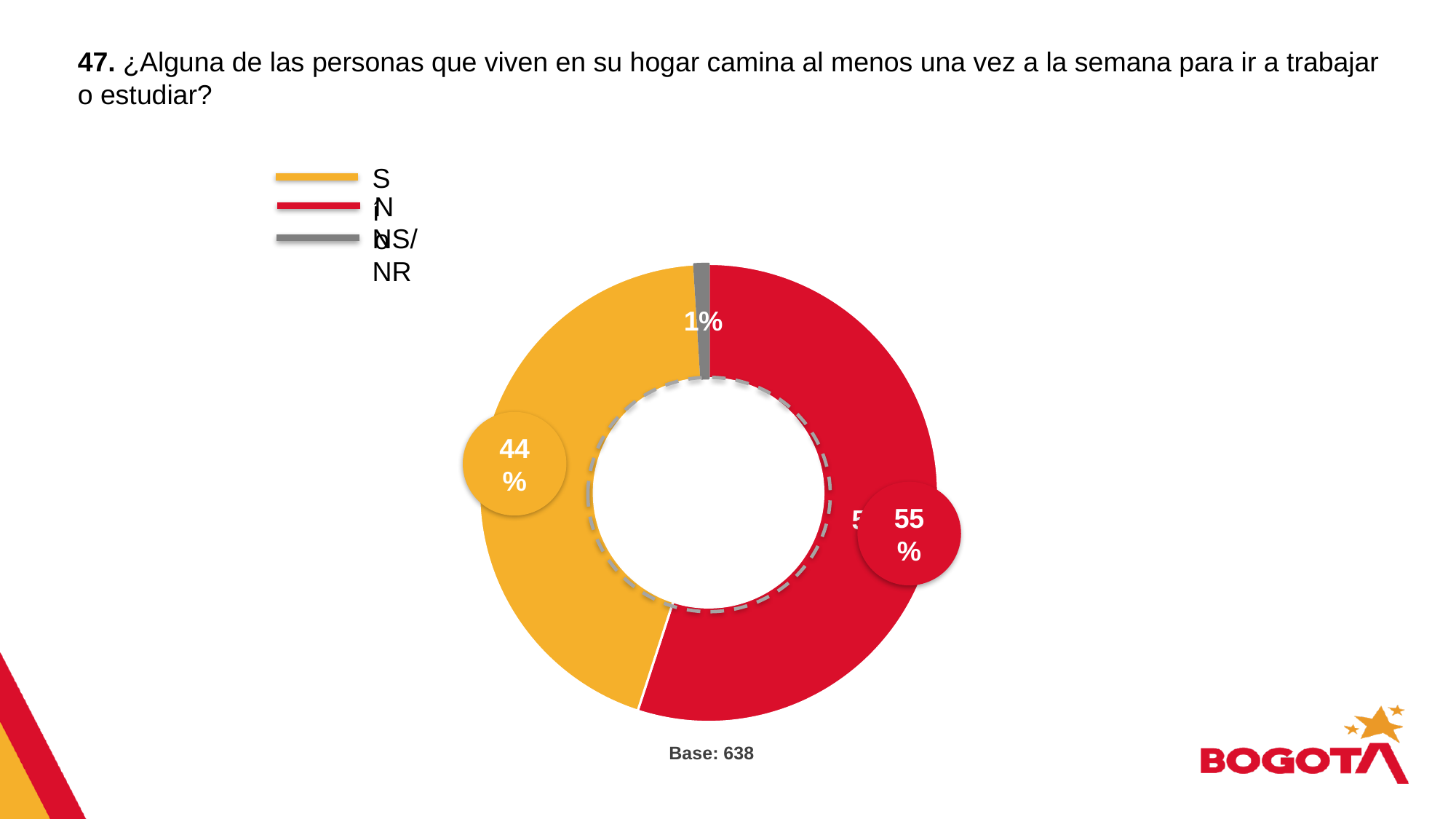
What base (number of respondents) is stated below the chart? 638 How many entries does the legend list? 3 Which is larger, the share for 'Sí' or the share for 'No'? No How many slices does the chart have? 3 What is the difference in percentage points between the 'No' share and the 'Sí' share? 11 percentage points What percentage is shown for the yellow 'Sí' slice? 44% Which response category has the largest share of the chart? No What percentage is shown for the red 'No' slice? 55% What percentage is shown for the grey 'NS/NR' slice? 1% Which response category has the smallest share of the chart? NS/NR What kind of chart is shown on the slide? pie chart (donut) What colour is used for the 'No' slice? red